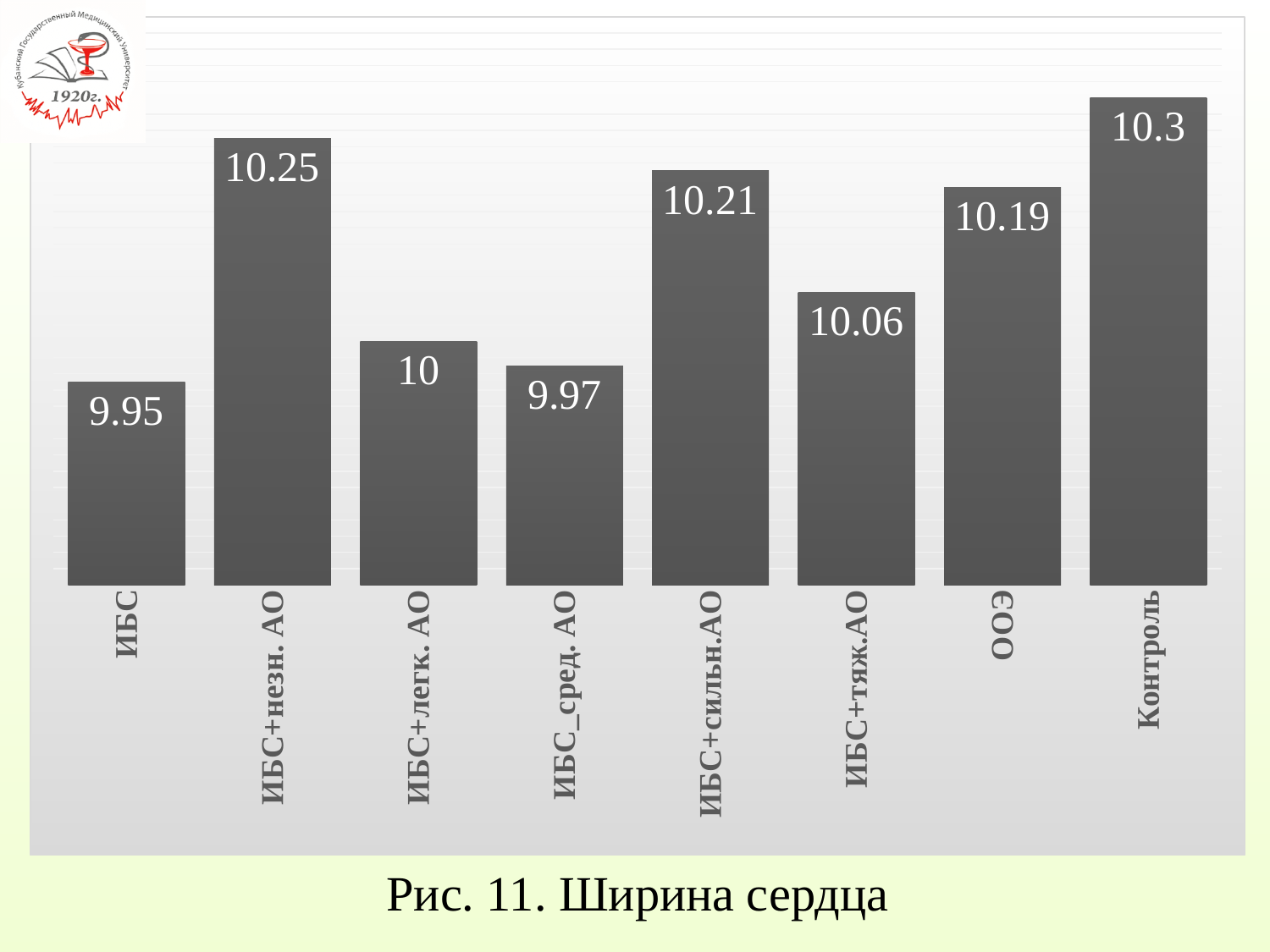
What is the value for ИБС+незн. АО? 10.25 Which category has the highest value? Контроль What is the caption of the chart? Рис. 11. Ширина сердца What is the difference between the values for Контроль and ИБС? 0.35 What kind of chart is shown on the slide? bar chart Which category has the lowest value? ИБС What is the value for ИБС? 9.95 What is the value for ИБС+тяж.АО? 10.06 How many categories are shown in the chart? 8 What is the difference between the values for ИБС+незн. АО and ИБС+легк. АО? 0.25